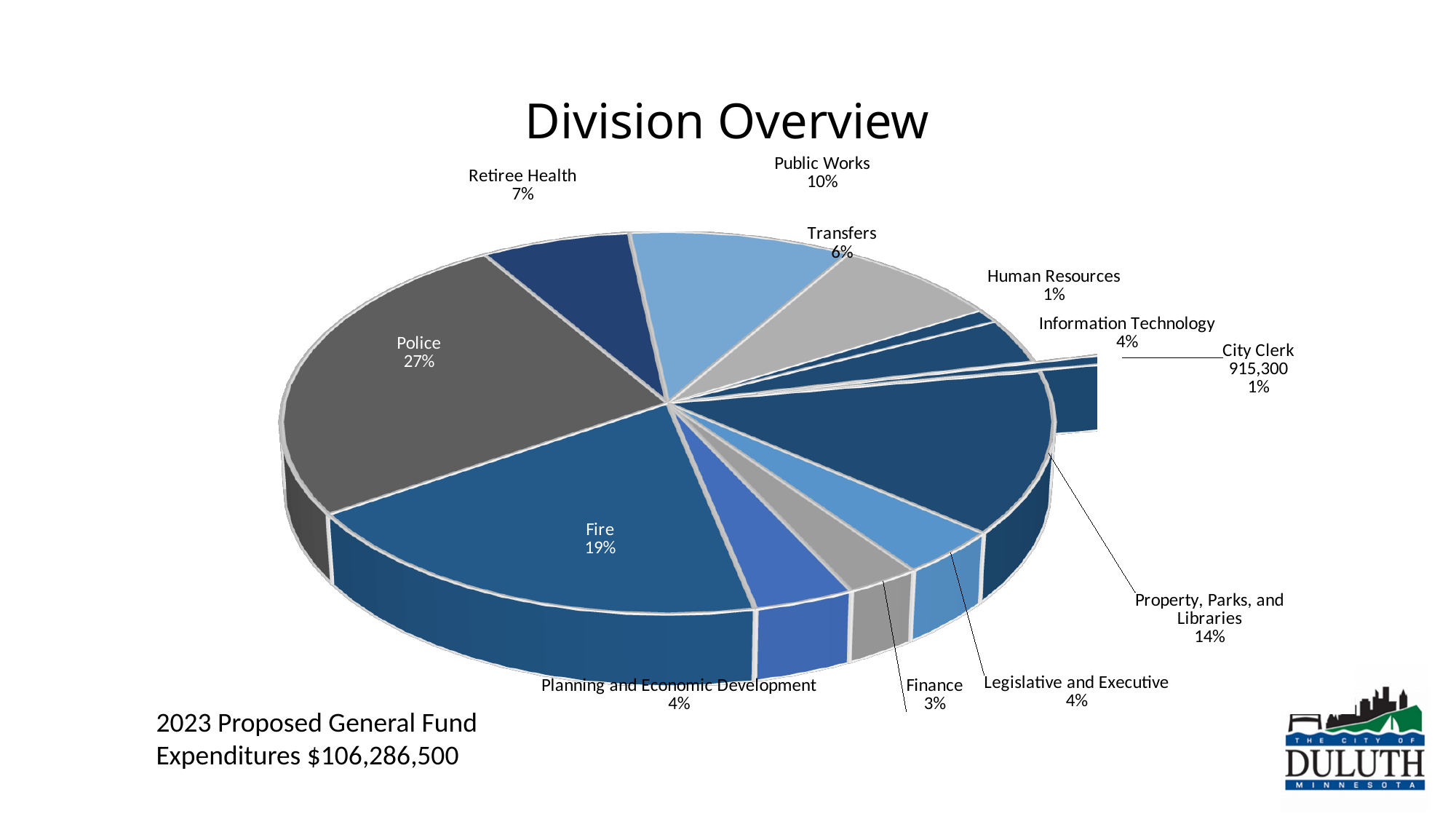
How many divisions are shown in the pie chart? 12 What share of the pie does Police account for? 27% What kind of chart is shown on the slide? Pie chart What total expenditure amount is stated on the slide for the 2023 Proposed General Fund? $106,286,500 What is the title of the chart? Division Overview Which is larger, Public Works or Retiree Health? Public Works What is the difference in percentage points between Police and Fire? 8 What value is printed for City Clerk besides its percentage? 915,300 What percentage is shown for Property, Parks, and Libraries? 14% What percentage is shown for Fire? 19% Which division has the largest slice of the pie? Police What percentage is shown for Transfers? 6%